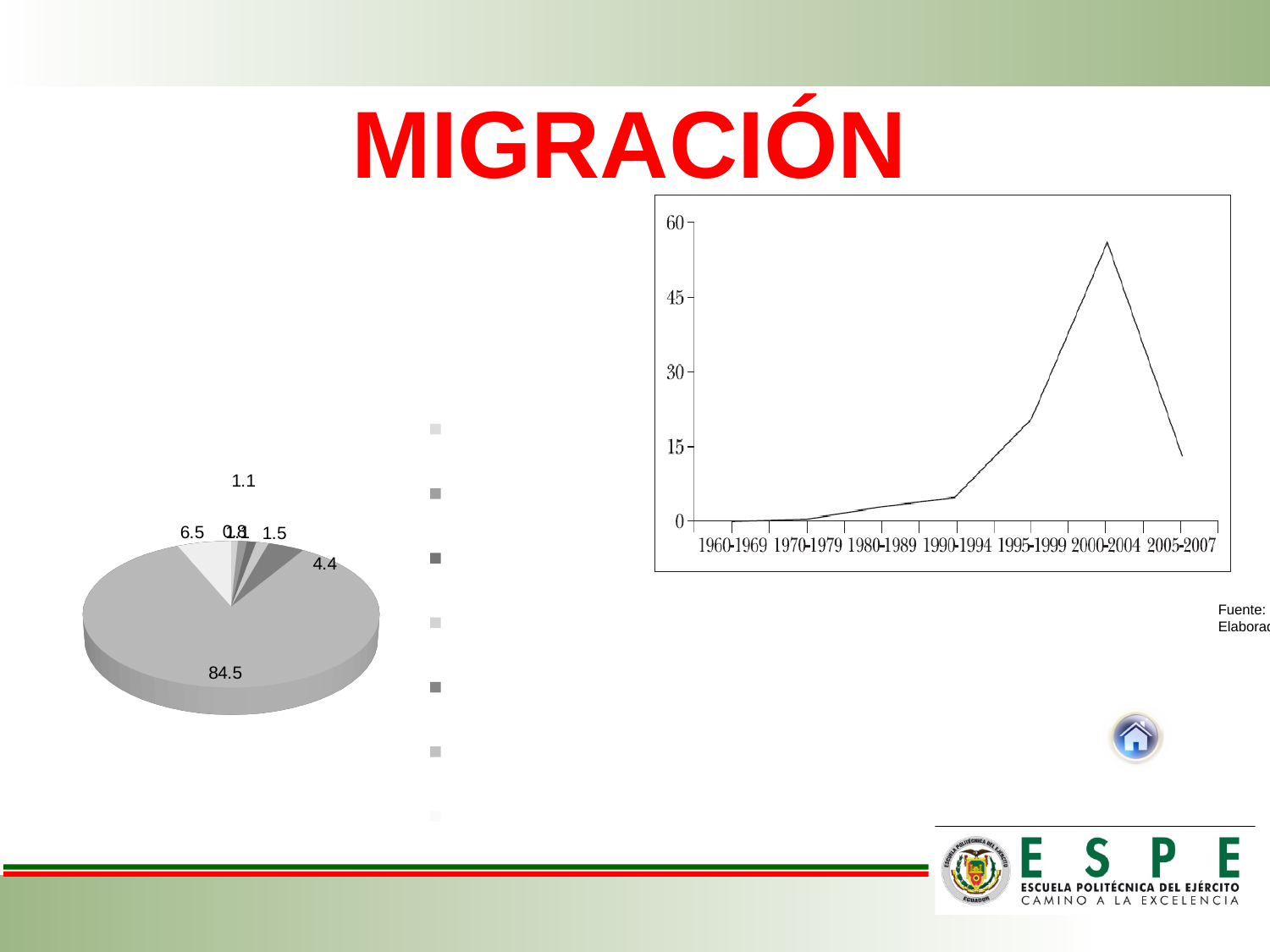
What kind of chart is the chart on the right of the slide? line chart In the pie chart on the left, what is the value of the largest slice? 84.5 What kind of chart is the chart on the left of the slide? pie chart In the pie chart on the left, which is larger, the slice labelled 6.5 or the slice labelled 4.4? 6.5 In the line chart on the right, does the value rise or fall between 2000-2004 and 2005-2007? fall In the line chart on the right, is the value for 2000-2004 greater or less than 45? greater How many periods are shown on the x axis of the line chart on the right? 7 In the line chart on the right, is the value for 1990-1994 greater or less than 15? less In the line chart on the right, which is larger, the value for 2000-2004 or the value for 2005-2007? 2000-2004 In the line chart on the right, which period has the lowest value? 1960-1969 In the line chart on the right, which period has the highest value? 2000-2004 In the pie chart on the left, what is the difference between the largest slice (84.5) and the slice labelled 6.5? 78.0